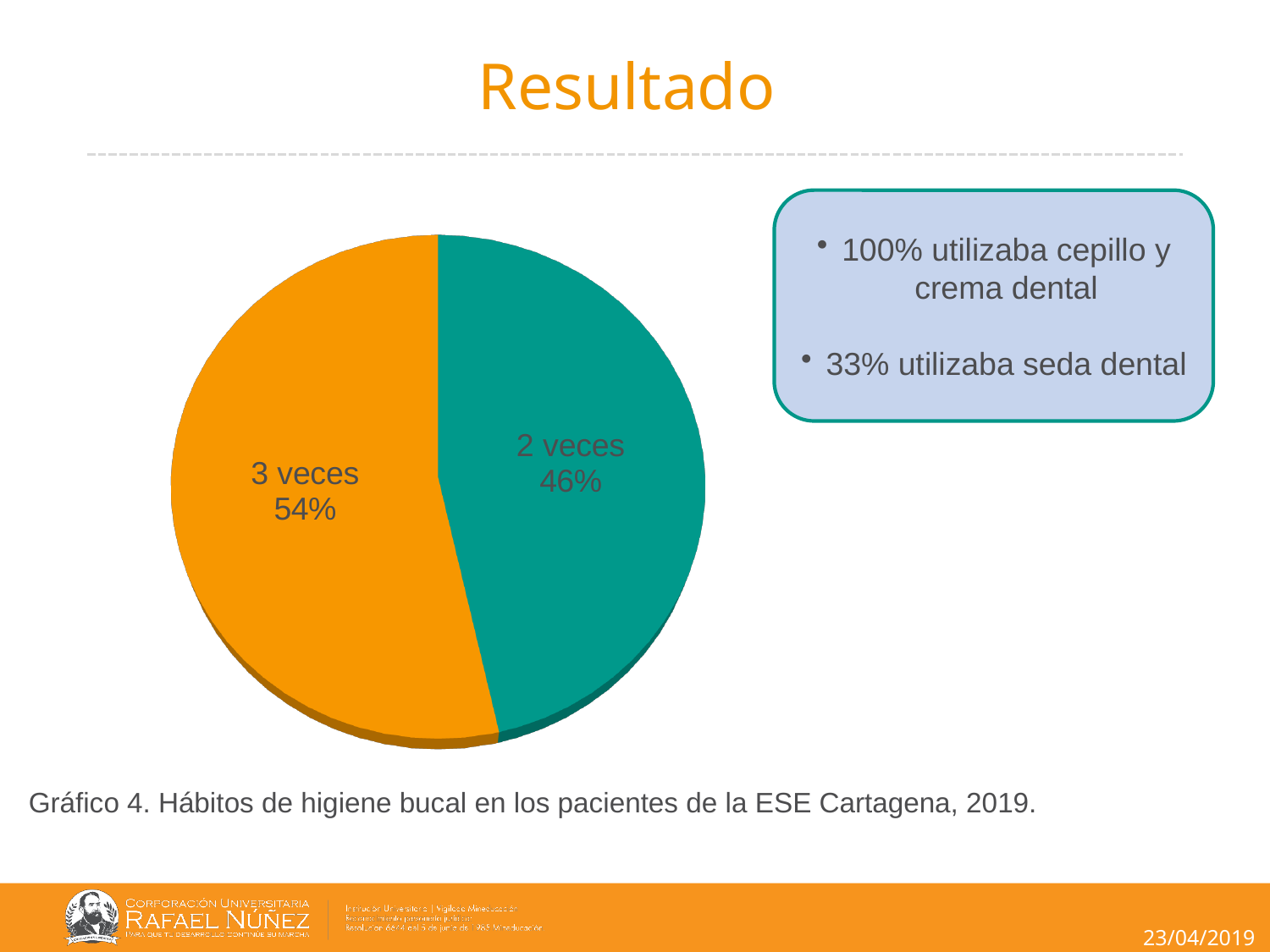
What percentage is shown for the "3 veces" slice? 54% What is the difference in percentage points between the "3 veces" and "2 veces" slices? 8 Which is larger, the "2 veces" slice or the "3 veces" slice? 3 veces Which slice of the pie is the largest? 3 veces What is the caption given for the chart below it? Gráfico 4. Hábitos de higiene bucal en los pacientes de la ESE Cartagena, 2019. Which slice of the pie is the smallest? 2 veces What percentage is shown for the "2 veces" slice? 46% What kind of chart is shown on the slide? pie chart What colour is the "3 veces" slice? orange How many slices does the pie chart have? 2 What share of the pie does the "2 veces" slice represent? 46%